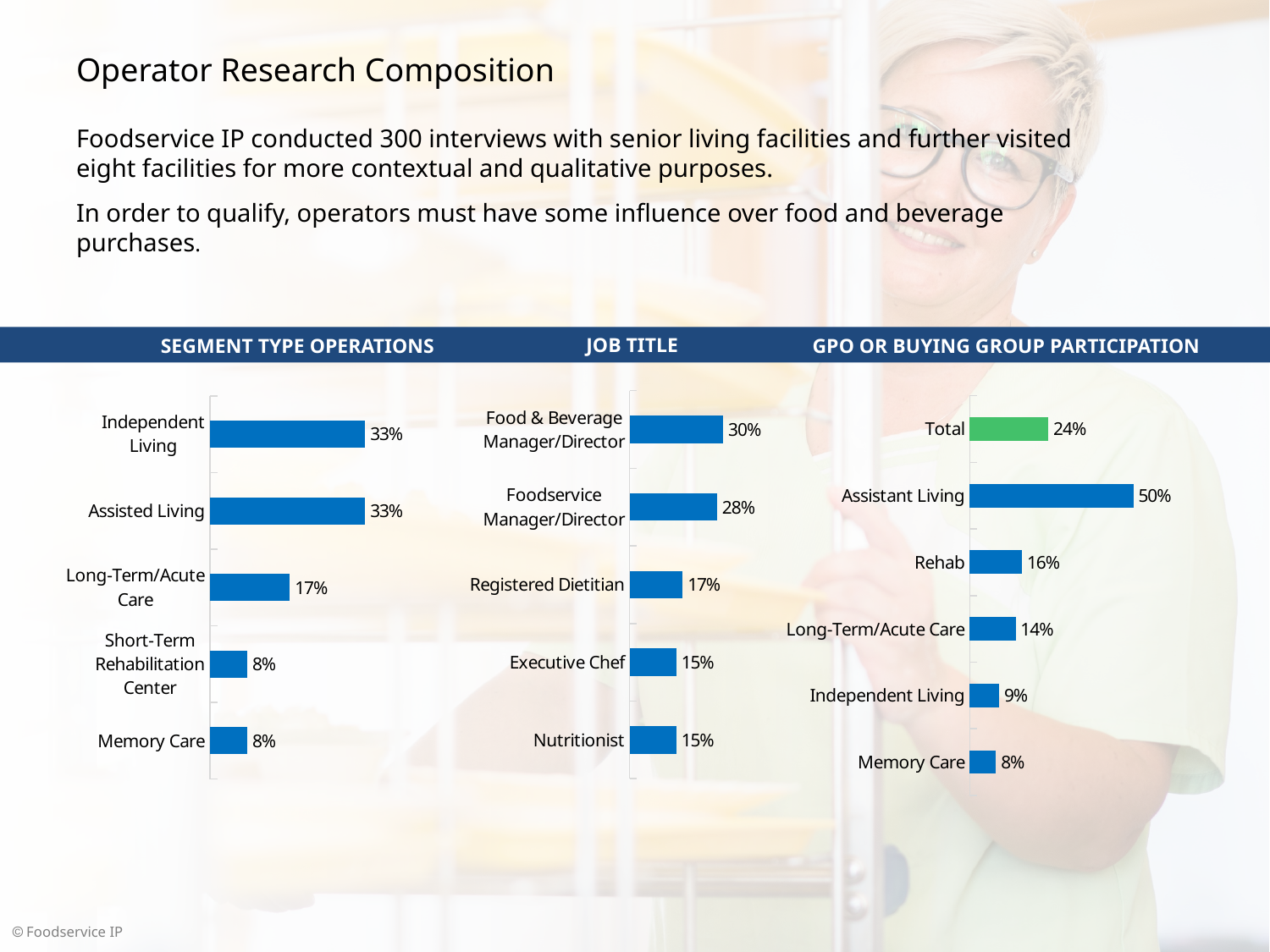
In the Segment Type Operations chart, what is the value for Memory Care? 8% In the GPO or Buying Group Participation chart, which is larger, Rehab or Long-Term/Acute Care? Rehab In the GPO or Buying Group Participation chart, which category has the lowest value? Memory Care How many categories are shown in the Job Title chart? 5 In the GPO or Buying Group Participation chart, what is the value for Total? 24% In the GPO or Buying Group Participation chart, which category has the highest value? Assistant Living In the Segment Type Operations chart, what is the value for Long-Term/Acute Care? 17% What kind of chart is the Segment Type Operations chart? Bar chart In the Job Title chart, which job title has the highest value? Food & Beverage Manager/Director In the Job Title chart, what is the difference between Food & Beverage Manager/Director and Executive Chef? 15% In the GPO or Buying Group Participation chart, what is the difference between Assistant Living and Independent Living? 41% In the Job Title chart, what is the value for Registered Dietitian? 17%